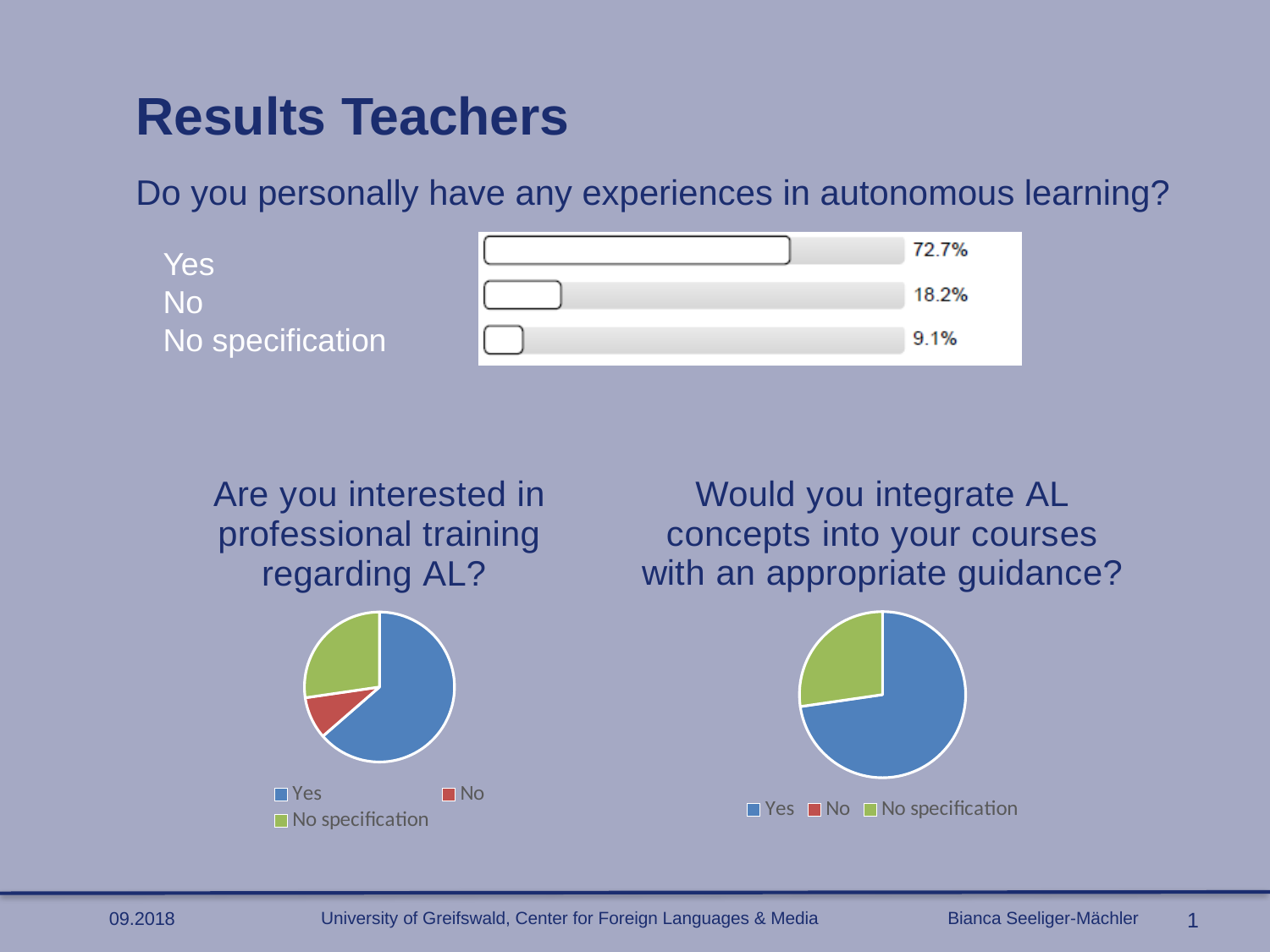
In the bar chart for 'Do you personally have any experiences in autonomous learning?', what is the difference between the values for Yes and No? 54.5% How many categories are shown in the bar chart for 'Do you personally have any experiences in autonomous learning?'? 3 In the bar chart for 'Do you personally have any experiences in autonomous learning?', which category has the highest value? Yes In the pie chart 'Are you interested in professional training regarding AL?', which category has the smallest slice? No In the pie chart 'Are you interested in professional training regarding AL?', which category has the largest slice? Yes What kind of chart is used for 'Are you interested in professional training regarding AL?'? Pie chart In the bar chart for 'Do you personally have any experiences in autonomous learning?', what is the value for Yes? 72.7% In the bar chart for 'Do you personally have any experiences in autonomous learning?', what is the value for No specification? 9.1% In the bar chart for 'Do you personally have any experiences in autonomous learning?', what is the value for No? 18.2% In the bar chart for 'Do you personally have any experiences in autonomous learning?', which category has the lowest value? No specification How many entries does the legend of the pie chart 'Would you integrate AL concepts into your courses with an appropriate guidance?' list? 3 What kind of chart is used for 'Do you personally have any experiences in autonomous learning?'? Bar chart